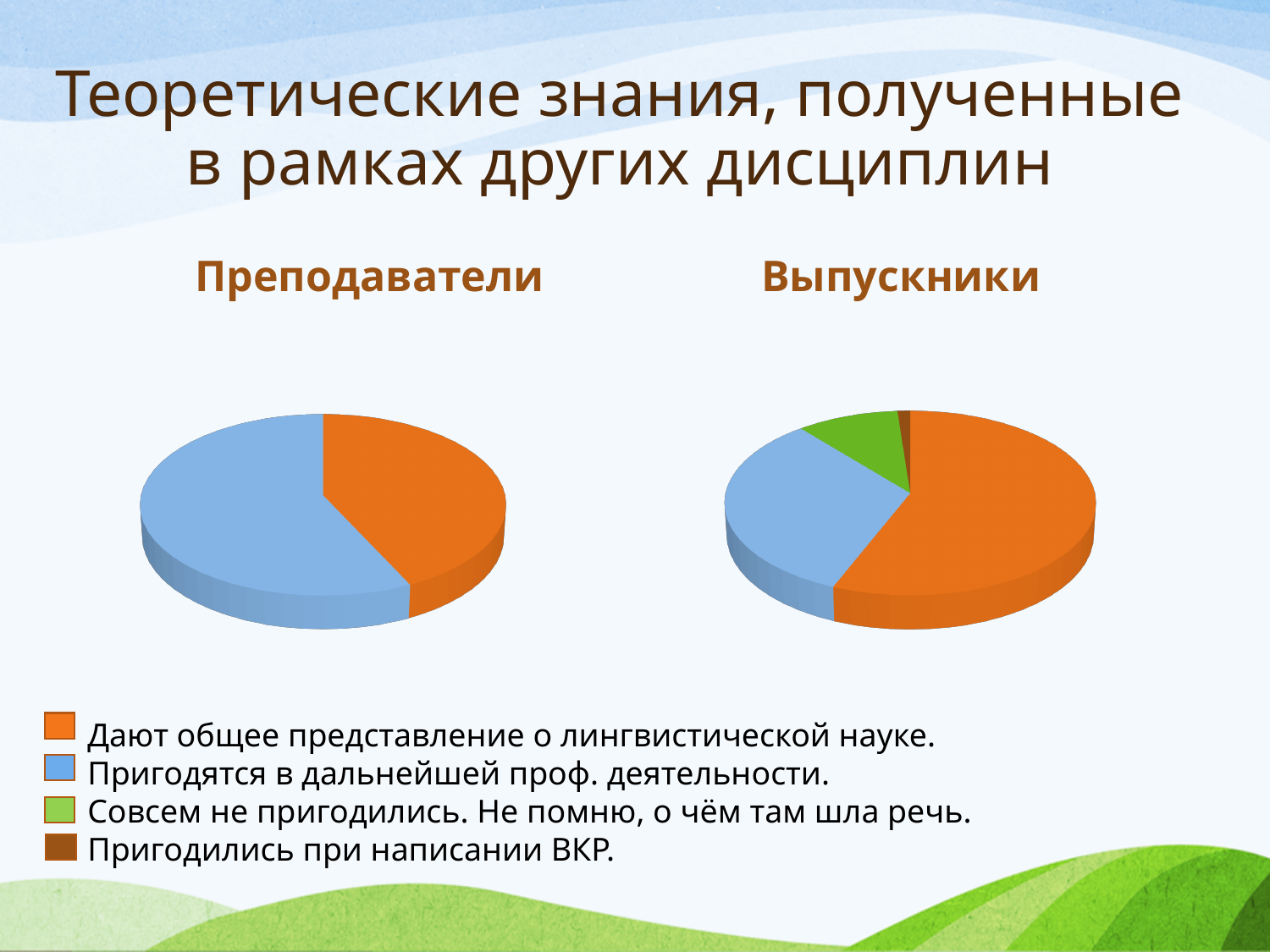
What is the title of the slide containing the two pie charts? Теоретические знания, полученные в рамках других дисциплин In the "Выпускники" pie chart, which category has the largest slice? Дают общее представление о лингвистической науке. In the "Выпускники" pie chart, which slice is larger: "Пригодятся в дальнейшей проф. деятельности." or "Совсем не пригодились. Не помню, о чём там шла речь."? Пригодятся в дальнейшей проф. деятельности. In the "Преподаватели" pie chart, which category has the largest slice? Пригодятся в дальнейшей проф. деятельности. In the "Преподаватели" pie chart, which slice is larger: "Дают общее представление о лингвистической науке." or "Пригодятся в дальнейшей проф. деятельности."? Пригодятся в дальнейшей проф. деятельности. In the "Преподаватели" pie chart, how many slices are shown? 2 In the "Выпускники" pie chart, which category has the smallest slice? Пригодились при написании ВКР. How many entries does the legend at the bottom of the slide list? 4 In the "Выпускники" pie chart, how many slices are shown? 4 What colour represents "Совсем не пригодились. Не помню, о чём там шла речь." in the legend? green What kind of chart is used under the heading "Выпускники"? pie chart What kind of chart is used under the heading "Преподаватели"? pie chart